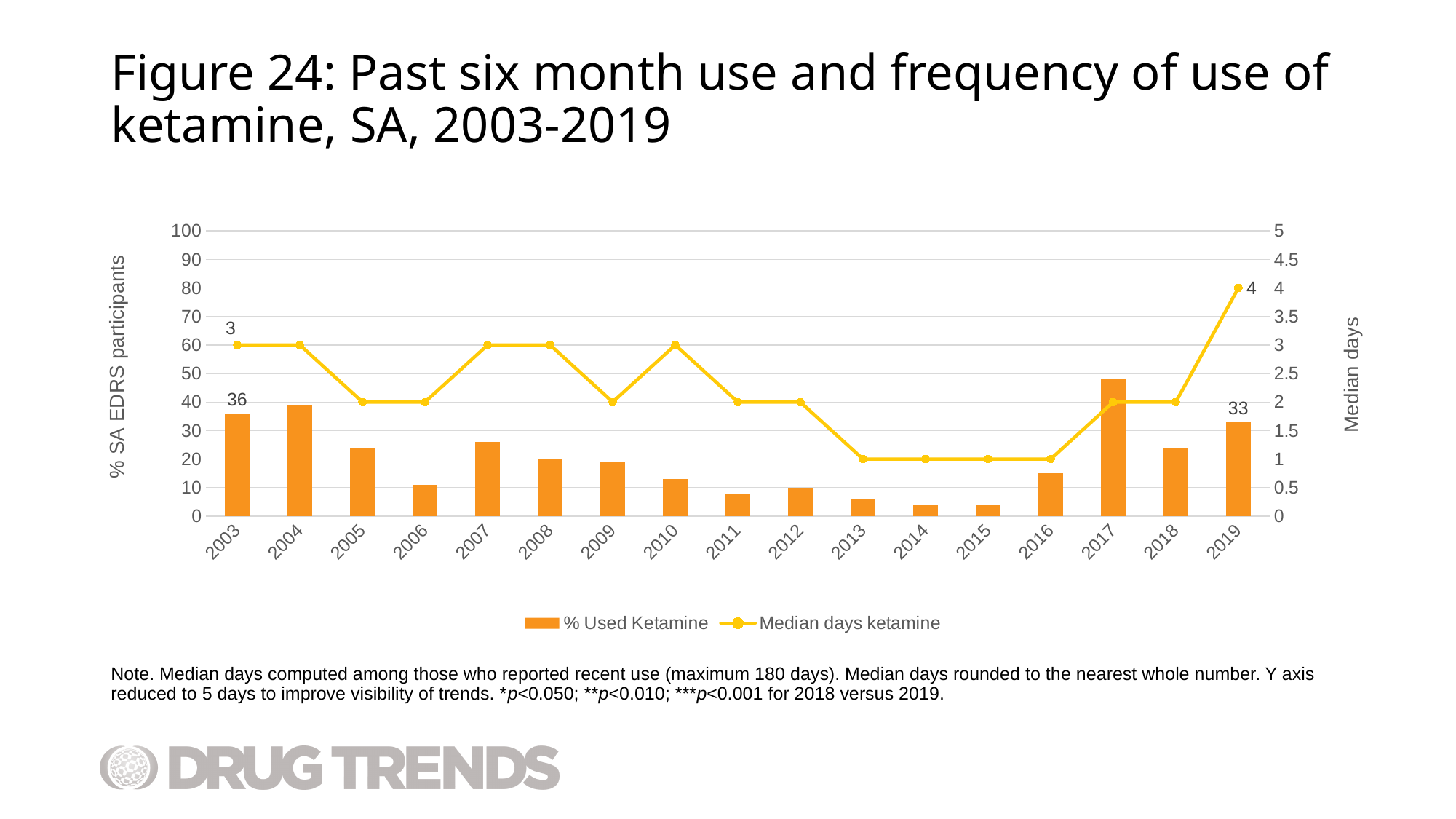
What is the median days ketamine value in 2013? 1 How many series does the legend list? 2 Which year has the highest % Used Ketamine bar? 2017 Is the % Used Ketamine value for 2017 greater or less than 40? greater What is the difference between the % Used Ketamine values in 2003 and 2019? 3 What is the value for % Used Ketamine in 2003? 36 How many years are shown on the x axis? 17 What is the value for % Used Ketamine in 2019? 33 Is the % Used Ketamine value for 2014 greater or less than 10? less What is the median days ketamine value in 2019? 4 Which year has the highest median days ketamine value? 2019 What is the median days ketamine value in 2003? 3